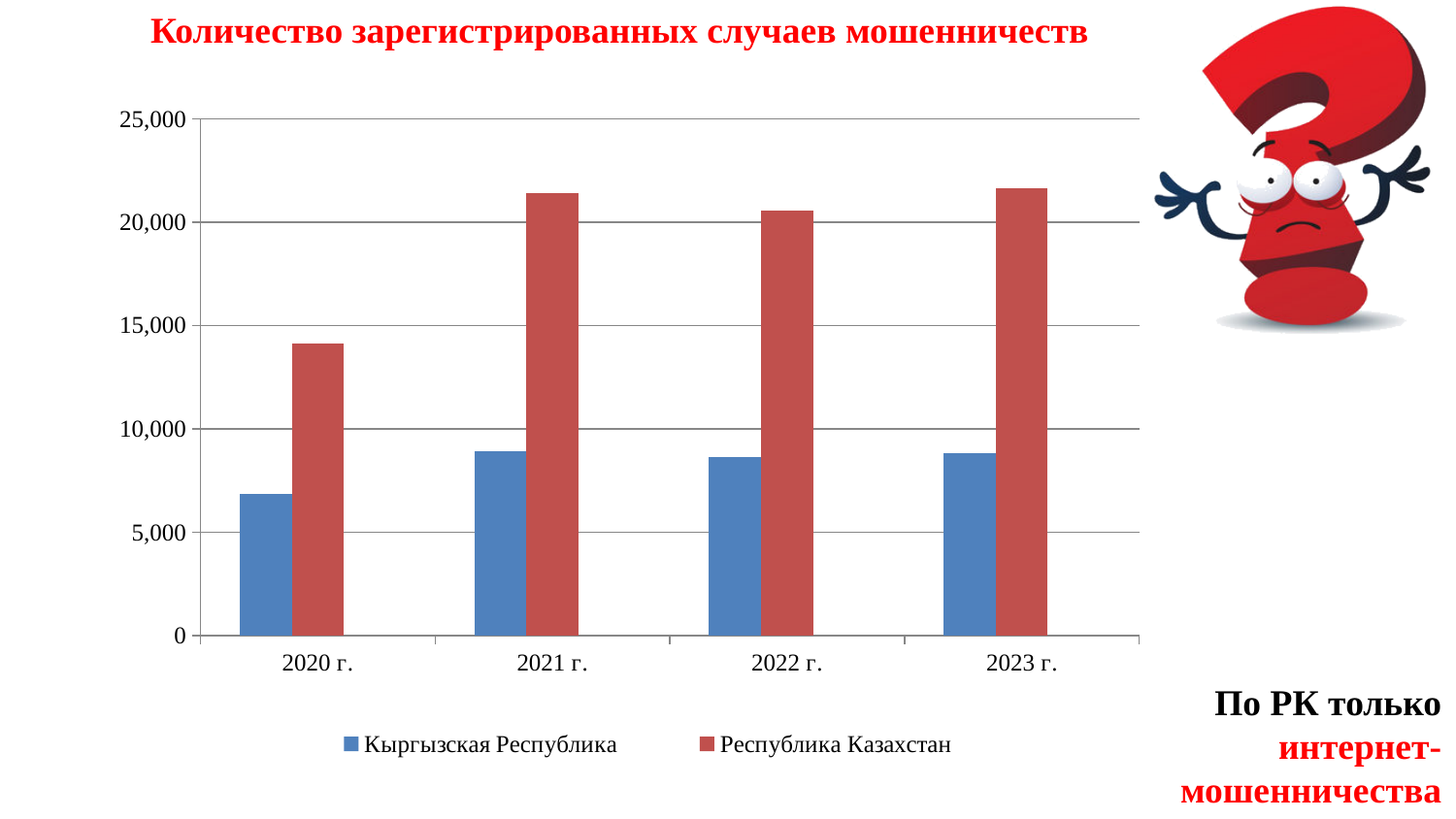
How many series does the legend list? 2 Which year has the lowest value for Республика Казахстан? 2020 г. Is the value for Кыргызская Республика in 2023 г. greater or less than 10,000? less Is the value for Республика Казахстан in 2020 г. greater or less than 15,000? less How many years are shown on the x axis? 4 For Республика Казахстан, does the value rise or fall from 2020 г. to 2021 г.? rise Is the value for Республика Казахстан in 2021 г. greater or less than 20,000? greater What kind of chart is shown on the slide? bar chart What is the title of the chart? Количество зарегистрированных случаев мошенничеств In 2022 г., which series has the larger value: Кыргызская Республика or Республика Казахстан? Республика Казахстан Which year has the lowest value for Кыргызская Республика? 2020 г.